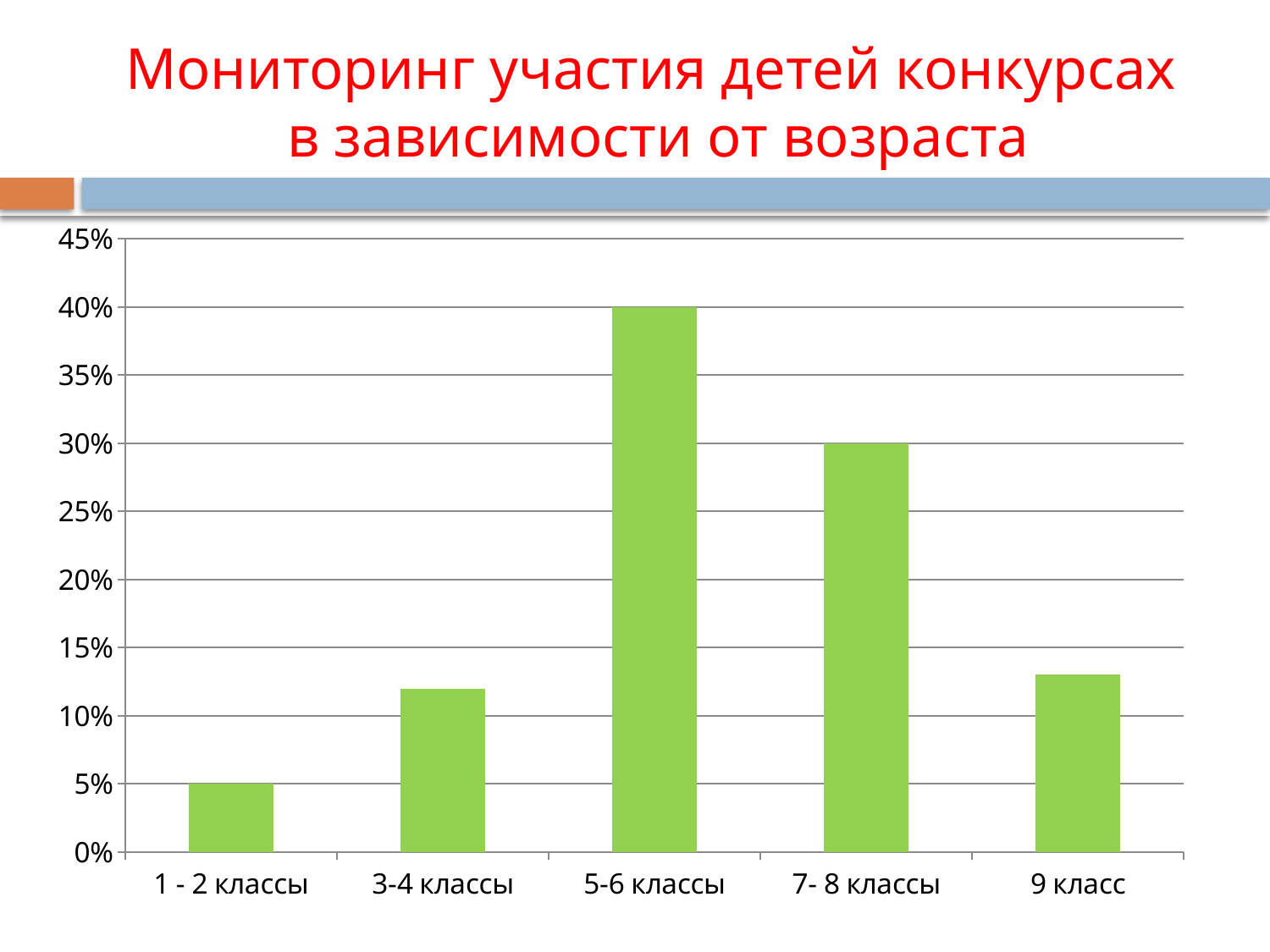
What type of chart is shown on the slide? bar chart Which category has the lowest value? 1 - 2 классы Is the value for 3-4 классы greater or less than 10%? greater Which is larger, the value for 7- 8 классы or the value for 9 класс? 7- 8 классы What is the difference between the values for 5-6 классы and 7- 8 классы? 10% What is the value for 1 - 2 классы? 5% Which category has the highest value? 5-6 классы What is the value for 7- 8 классы? 30% Is the value for 9 класс greater or less than 15%? less What is the title of the slide containing the chart? Мониторинг участия детей конкурсах в зависимости от возраста How many categories are shown on the x axis? 5 What is the value for 5-6 классы? 40%